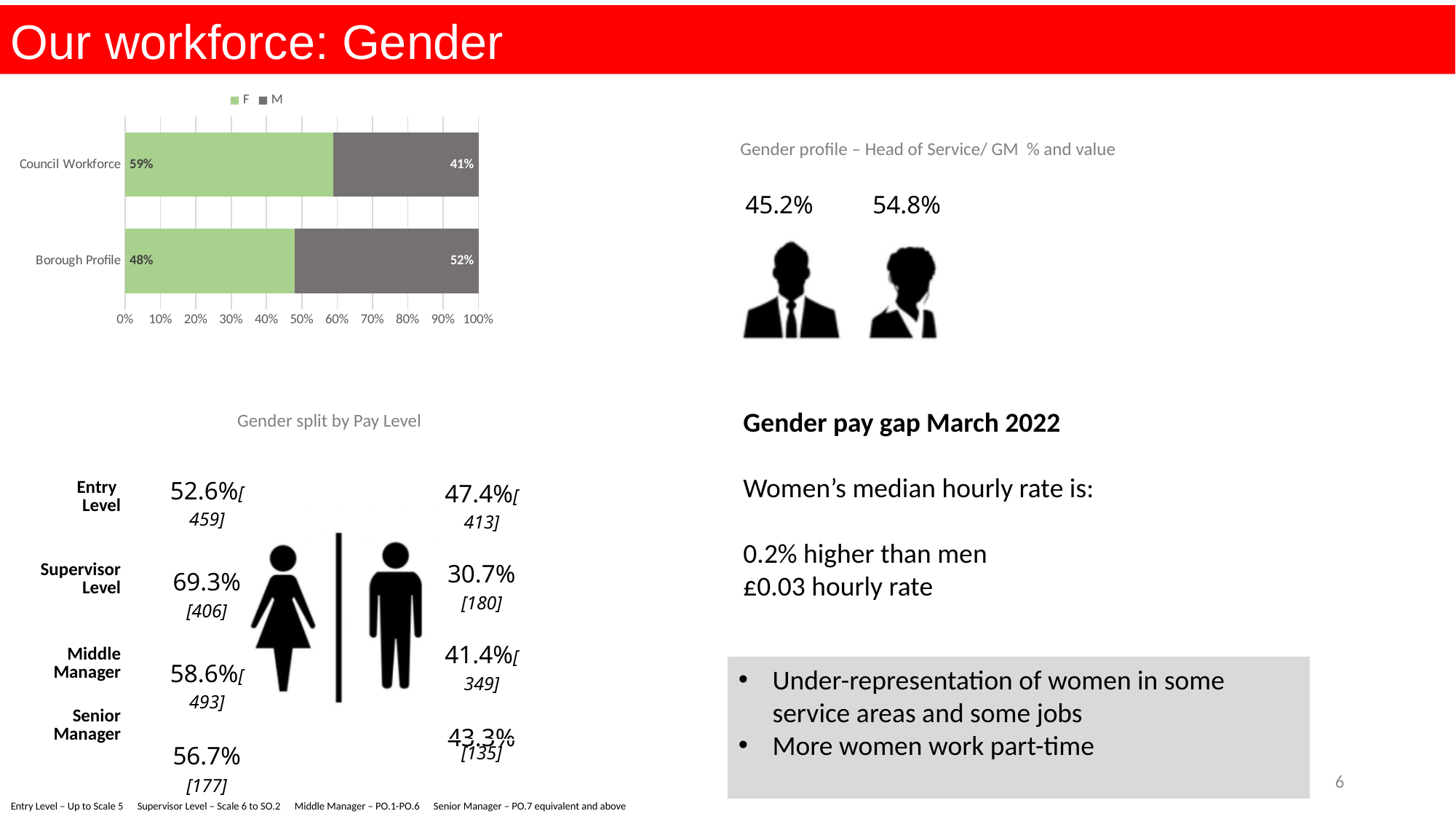
In the top-left bar chart, what is the F value for Council Workforce? 59% In the top-left bar chart, what is the difference between the F and M values for Council Workforce? 18% What type of chart is shown at the top left of the slide? bar chart In the top-left bar chart, how many series does the legend list? 2 In the top-left bar chart, what is the M value for Borough Profile? 52% In the top-left bar chart, is the F value for Borough Profile larger or smaller than the M value for Borough Profile? smaller In the top-left bar chart, which colour represents the F series? green In the top-left bar chart, what is the total of the stacked bar for Borough Profile? 100% In the top-left bar chart, what is the M value for Council Workforce? 41% In the top-left bar chart, which category has the higher F value? Council Workforce In the top-left bar chart, how many categories are shown? 2 In the top-left bar chart, what is the F value for Borough Profile? 48%